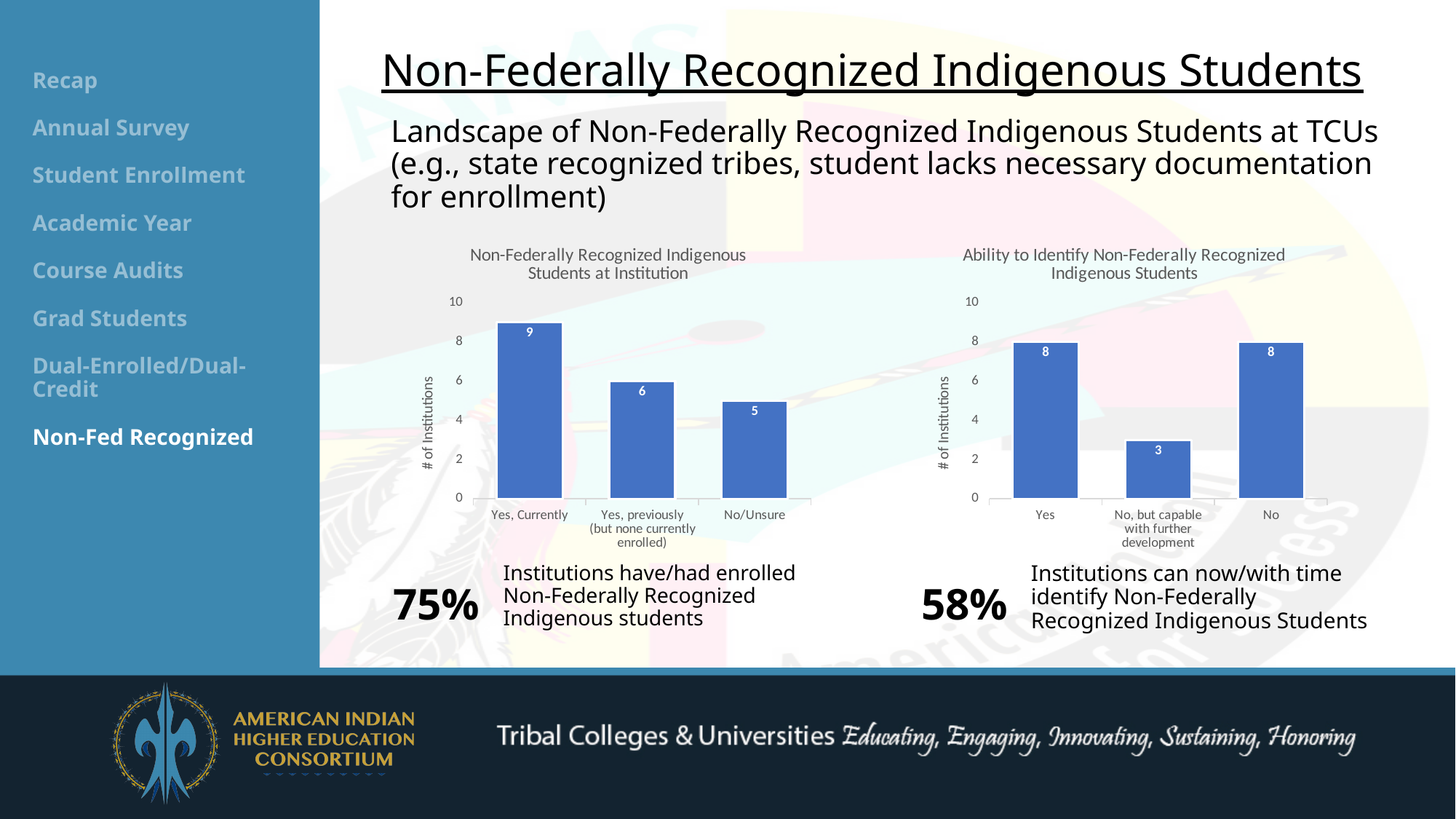
What type of chart is the 'Ability to Identify Non-Federally Recognized Indigenous Students' chart? bar chart In the 'Ability to Identify Non-Federally Recognized Indigenous Students' chart, what is the value for 'No, but capable with further development'? 3 In the 'Ability to Identify Non-Federally Recognized Indigenous Students' chart, is the value for 'Yes' larger or smaller than the value for 'No, but capable with further development'? larger In the 'Ability to Identify Non-Federally Recognized Indigenous Students' chart, which category has the lowest value? No, but capable with further development What is the y-axis label on the 'Non-Federally Recognized Indigenous Students at Institution' chart? # of Institutions In the 'Non-Federally Recognized Indigenous Students at Institution' chart, how many categories are shown on the x axis? 3 In the 'Non-Federally Recognized Indigenous Students at Institution' chart, do the values rise or fall from left to right? fall In the 'Non-Federally Recognized Indigenous Students at Institution' chart, what is the difference between 'Yes, Currently' and 'Yes, previously (but none currently enrolled)'? 3 In the 'Non-Federally Recognized Indigenous Students at Institution' chart, which category has the highest value? Yes, Currently In the 'Non-Federally Recognized Indigenous Students at Institution' chart, what is the value for 'No/Unsure'? 5 In the 'Non-Federally Recognized Indigenous Students at Institution' chart, how many institutions answered 'Yes, Currently'? 9 In the 'Ability to Identify Non-Federally Recognized Indigenous Students' chart, what is the difference between 'Yes' and 'No, but capable with further development'? 5